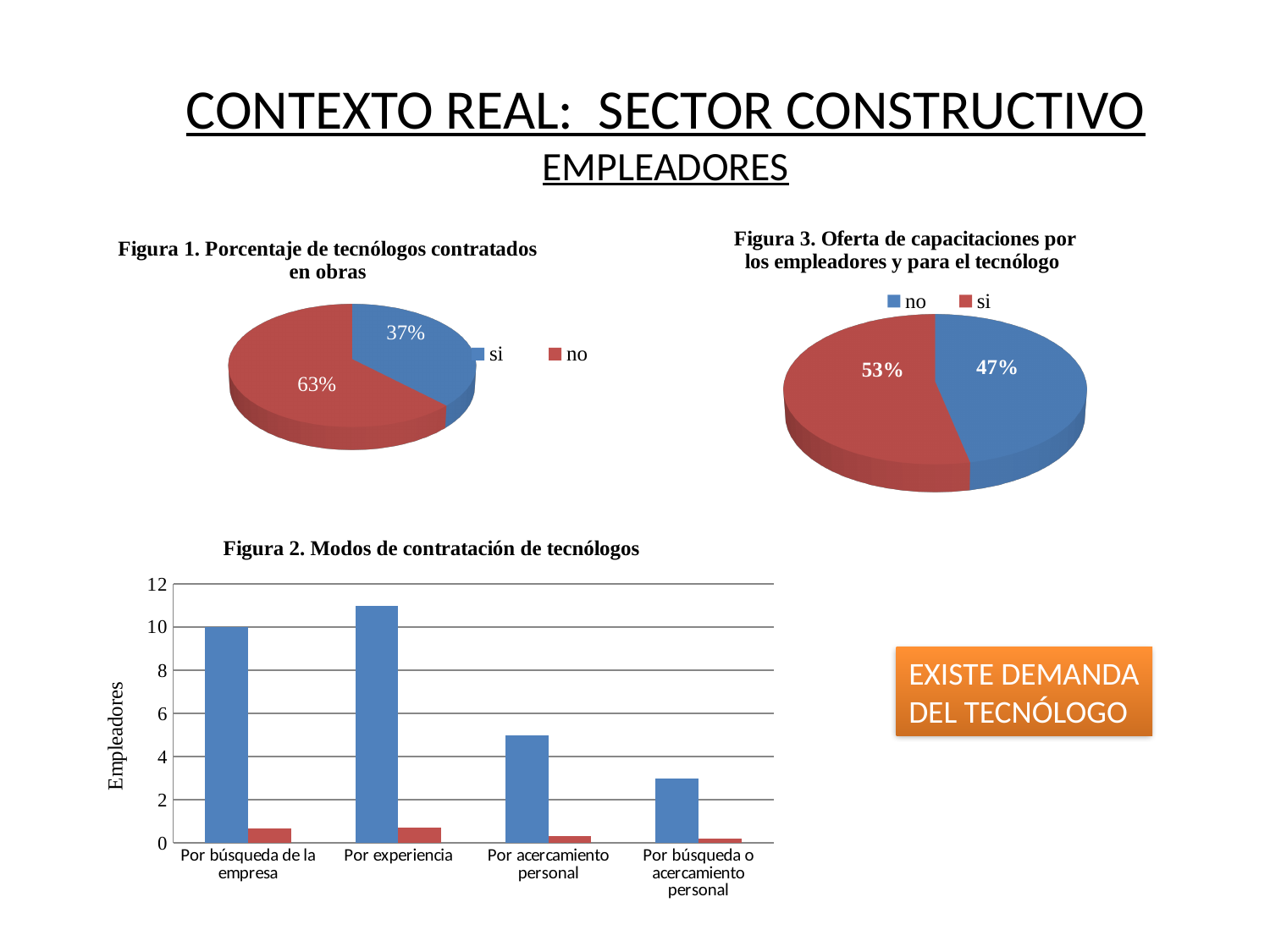
In Figura 1 (Porcentaje de tecnólogos contratados en obras), what share of the pie is 'si'? 37% In Figura 1 (Porcentaje de tecnólogos contratados en obras), what is the difference between the 'no' and 'si' shares? 26% In Figura 3 (Oferta de capacitaciones por los empleadores y para el tecnólogo), what share of the pie is 'si'? 53% In Figura 3 (Oferta de capacitaciones por los empleadores y para el tecnólogo), which slice is larger, 'no' or 'si'? si In Figura 1 (Porcentaje de tecnólogos contratados en obras), what share of the pie is 'no'? 63% How many categories are shown on the x axis of Figura 2 (Modos de contratación de tecnólogos)? 4 What kind of chart is Figura 2 (Modos de contratación de tecnólogos)? Bar chart How many entries does the legend of Figura 3 (Oferta de capacitaciones por los empleadores y para el tecnólogo) list? 2 In Figura 2 (Modos de contratación de tecnólogos), which category has the shortest blue bar? Por búsqueda o acercamiento personal What kind of chart is Figura 3 (Oferta de capacitaciones por los empleadores y para el tecnólogo)? Pie chart In Figura 2 (Modos de contratación de tecnólogos), is the blue bar for 'Por acercamiento personal' greater or less than 6? less In Figura 2 (Modos de contratación de tecnólogos), which category has the tallest blue bar? Por experiencia